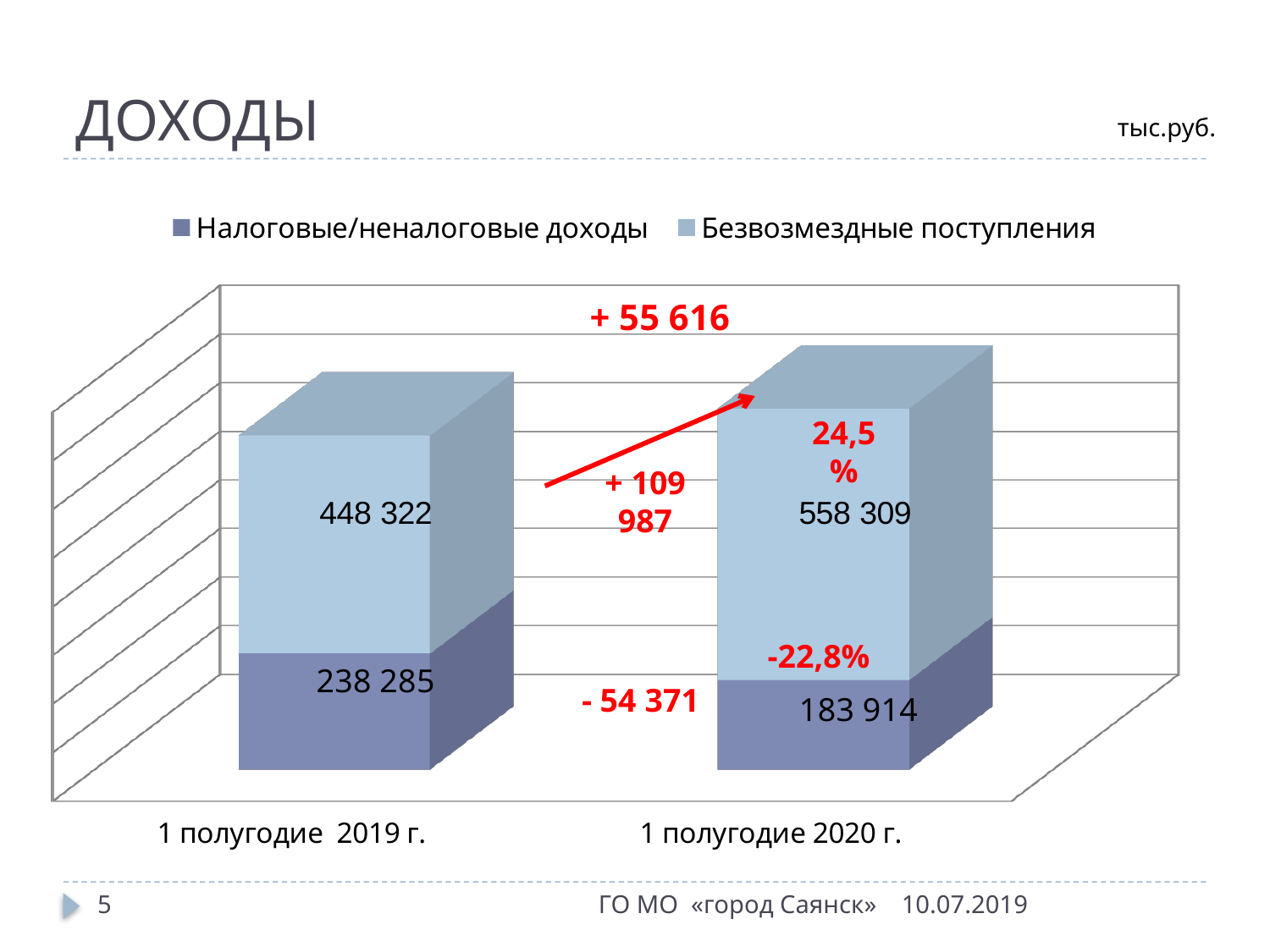
What is the value of Безвозмездные поступления for 1 полугодие 2019 г.? 448 322 How many series does the legend list? 2 What is the difference in Безвозмездные поступления between 1 полугодие 2020 г. and 1 полугодие 2019 г.? 109 987 What is the total of the stacked bar for 1 полугодие 2019 г.? 686 607 By how much did Налоговые/неналоговые доходы decrease from 1 полугодие 2019 г. to 1 полугодие 2020 г.? 54 371 What is the total of the stacked bar for 1 полугодие 2020 г.? 742 223 What kind of chart is shown on the slide? Stacked bar chart What is the value of Налоговые/неналоговые доходы for 1 полугодие 2019 г.? 238 285 What is the value of Налоговые/неналоговые доходы for 1 полугодие 2020 г.? 183 914 How many categories are shown on the x axis? 2 Which period has the larger value for Налоговые/неналоговые доходы, 1 полугодие 2019 г. or 1 полугодие 2020 г.? 1 полугодие 2019 г. What is the value of Безвозмездные поступления for 1 полугодие 2020 г.? 558 309